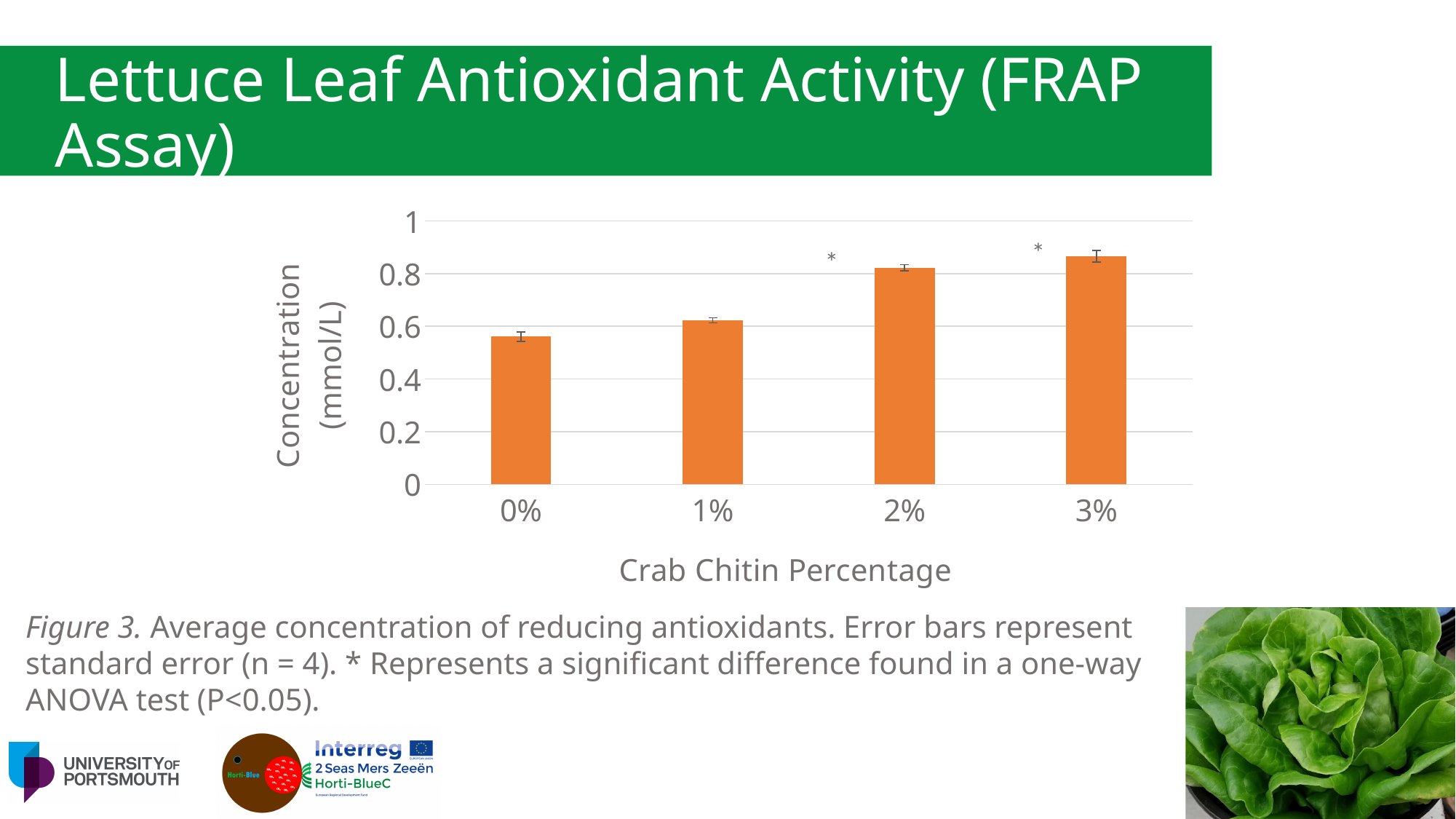
Is the concentration for 1% crab chitin greater or less than 0.8 mmol/L? less What kind of chart is shown on the slide? bar chart Does the concentration rise or fall as the crab chitin percentage increases from 0% to 3%? rise Is the concentration for 2% crab chitin greater or less than 0.8 mmol/L? greater Is the concentration for 0% crab chitin greater or less than 0.6 mmol/L? less What unit is shown on the y axis of the chart? mmol/L Which crab chitin percentage has the lowest concentration? 0% How many crab chitin percentage categories are plotted on the chart? 4 What is the title of the x axis of the chart? Crab Chitin Percentage Which crab chitin percentage has the highest concentration? 3% Which has the larger concentration, 1% or 2% crab chitin? 2%